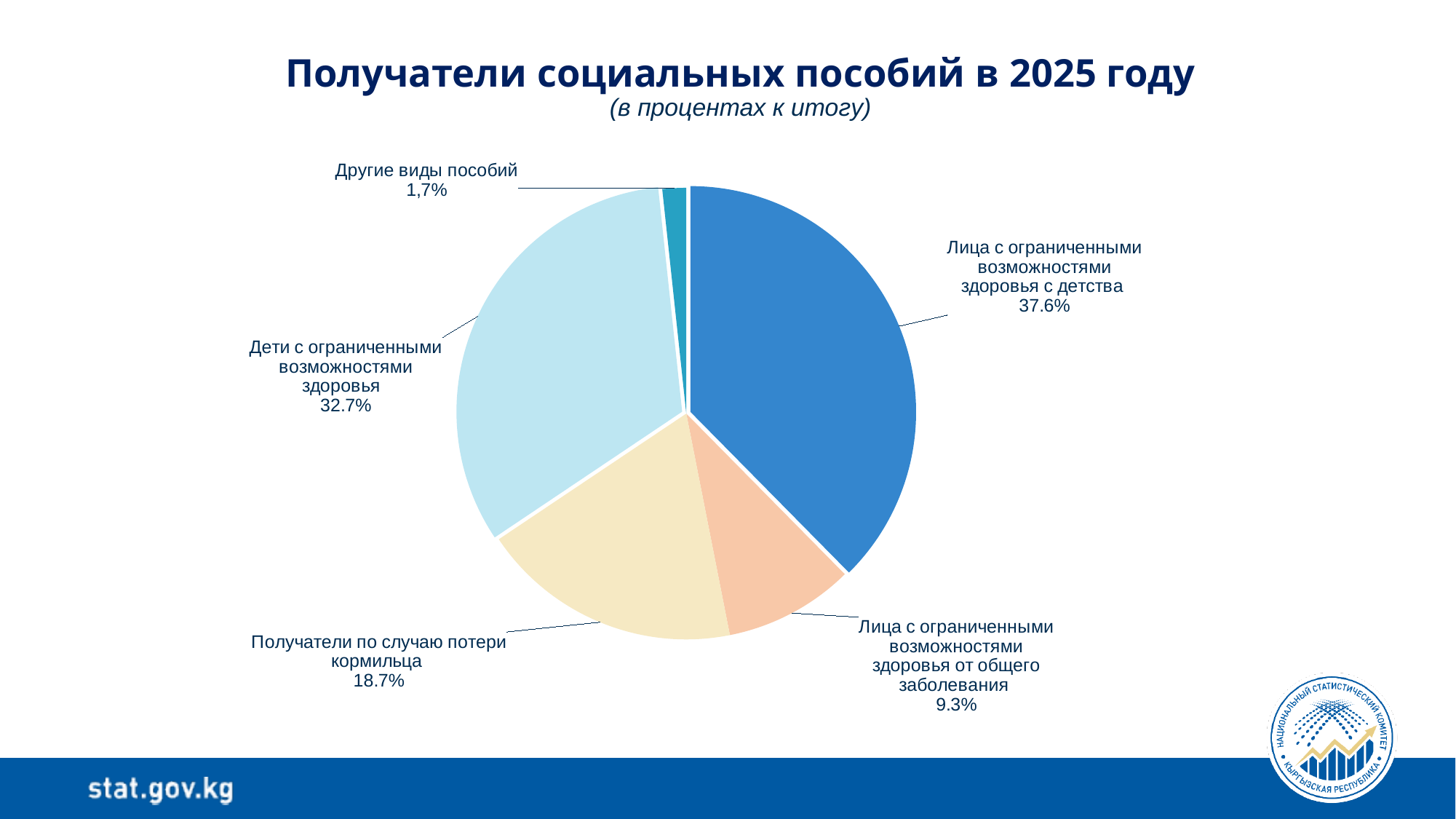
Which category has the largest slice of the pie? Лица с ограниченными возможностями здоровья с детства What is the difference in percentage points between "Лица с ограниченными возможностями здоровья с детства" and "Дети с ограниченными возможностями здоровья"? 4.9 What is the share for "Получатели по случаю потери кормильца"? 18.7% What is the share for "Лица с ограниченными возможностями здоровья с детства"? 37.6% What is the share for "Лица с ограниченными возможностями здоровья от общего заболевания"? 9.3% What is the title of the chart? Получатели социальных пособий в 2025 году Which is larger: the share for "Получатели по случаю потери кормильца" or the share for "Лица с ограниченными возможностями здоровья от общего заболевания"? Получатели по случаю потери кормильца What is the share for "Другие виды пособий"? 1,7% What is the share for "Дети с ограниченными возможностями здоровья"? 32.7% Which category has the smallest slice of the pie? Другие виды пособий What kind of chart is shown on the slide? pie chart How many slices does the pie chart have? 5